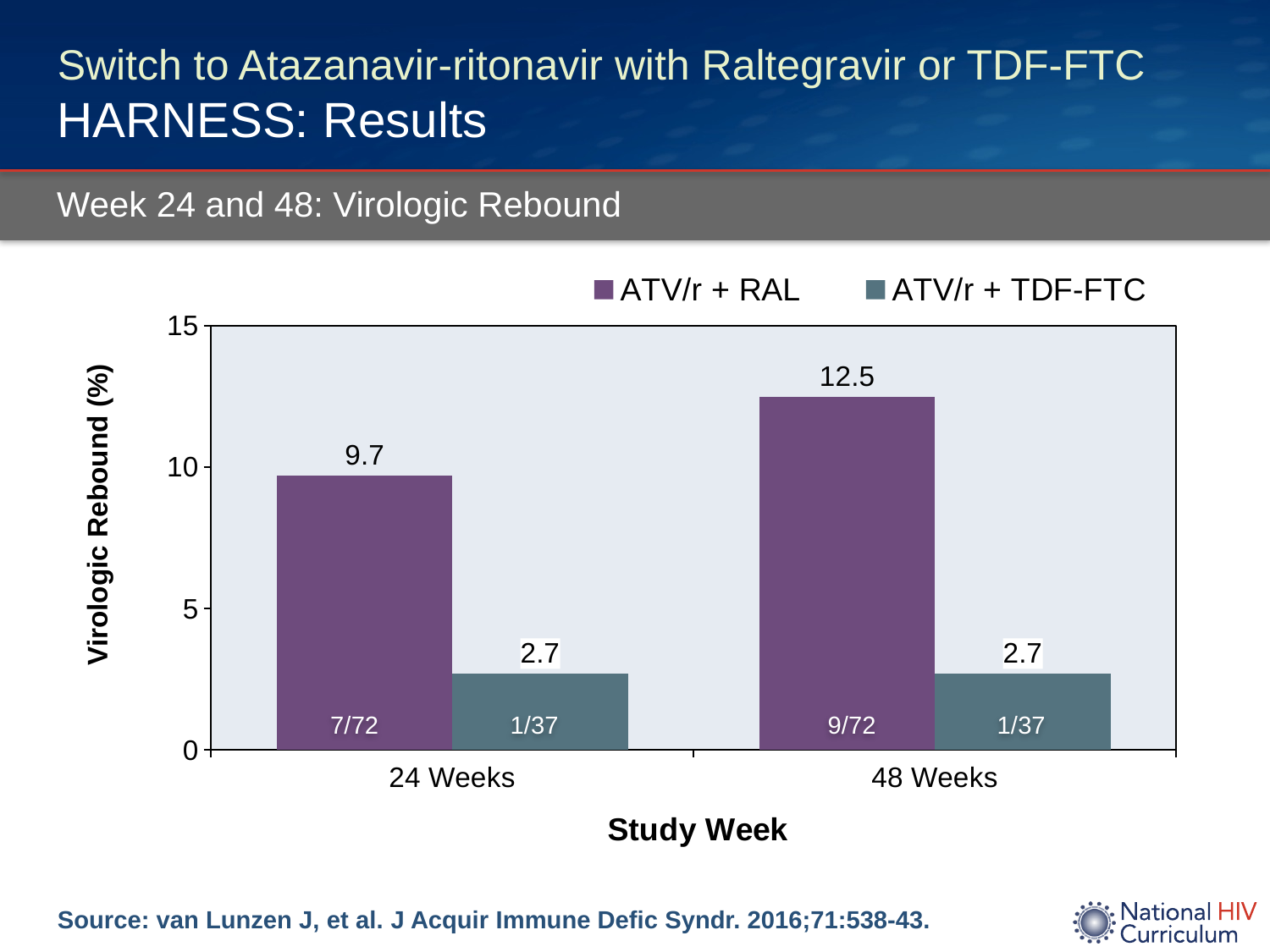
What is the virologic rebound percentage for ATV/r + RAL at 48 weeks? 12.5 What is the label of the y axis? Virologic Rebound (%) How many participants with virologic rebound out of the total are shown for ATV/r + RAL at 48 weeks? 9/72 What is the virologic rebound percentage for ATV/r + TDF-FTC at 48 weeks? 2.7 What kind of chart is shown on the slide? Bar chart What is the difference in virologic rebound percentage for ATV/r + RAL between 48 weeks and 24 weeks? 2.8 How many series does the legend list? 2 Is the value for ATV/r + RAL at 48 weeks greater or less than 10? greater What is the difference in virologic rebound percentage between ATV/r + RAL and ATV/r + TDF-FTC at 24 weeks? 7.0 Which bar shows the highest virologic rebound percentage? ATV/r + RAL at 48 Weeks What is the virologic rebound percentage for ATV/r + RAL at 24 weeks? 9.7 At 48 weeks, which arm has the larger virologic rebound percentage, ATV/r + RAL or ATV/r + TDF-FTC? ATV/r + RAL